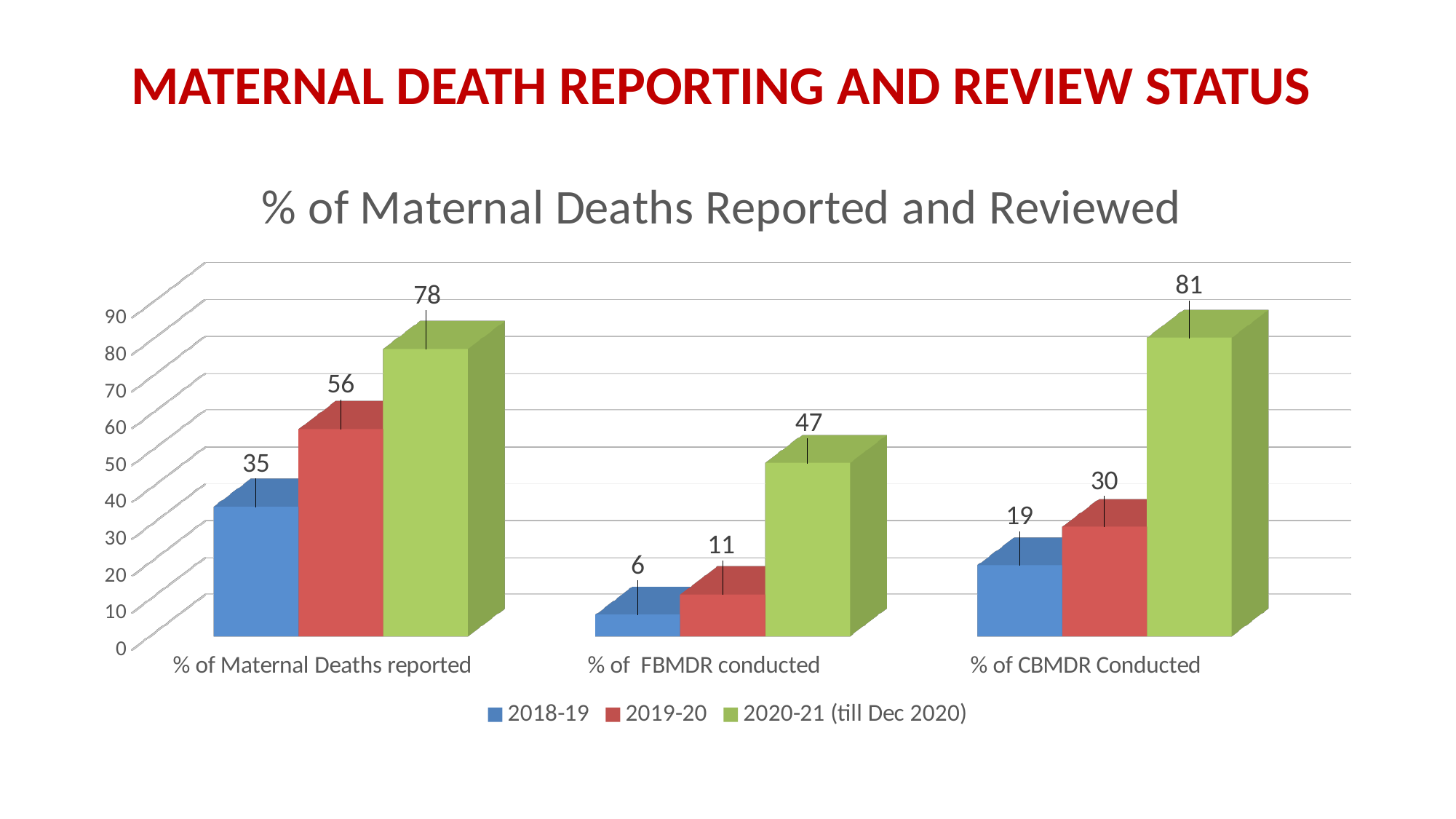
How many series does the legend list? 3 What is the difference between the 2020-21 (till Dec 2020) and 2018-19 values in the '% of Maternal Deaths reported' category? 43 Which category has the highest value for the 2020-21 (till Dec 2020) series? % of CBMDR Conducted Which is larger: the 2019-20 value for '% of Maternal Deaths reported' or the 2020-21 (till Dec 2020) value for '% of FBMDR conducted'? 2019-20 value for % of Maternal Deaths reported What is the value for 2019-20 in the '% of CBMDR Conducted' category? 30 Which category has the lowest value for the 2018-19 series? % of FBMDR conducted How many categories are shown on the x axis? 3 What kind of chart is shown on the slide? Bar chart What is the title of the chart? % of Maternal Deaths Reported and Reviewed What is the value for 2018-19 in the '% of FBMDR conducted' category? 6 What is the value for 2020-21 (till Dec 2020) in the '% of Maternal Deaths reported' category? 78 What is the difference between the 2019-20 and 2018-19 values in the '% of CBMDR Conducted' category? 11